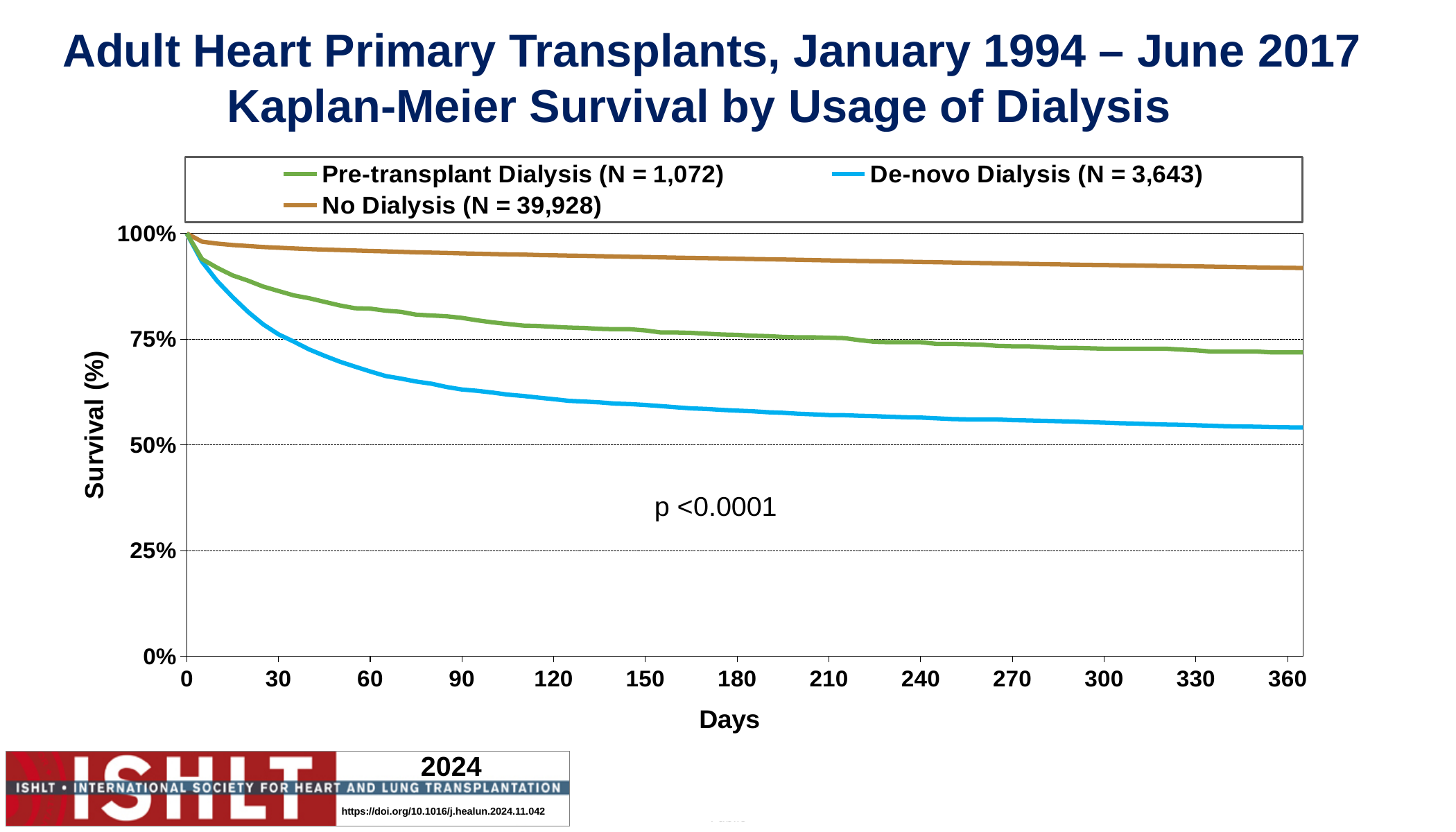
Is the survival for No Dialysis at 360 days greater or less than 75%? greater Is the survival for De-novo Dialysis at 360 days greater or less than 50%? greater What is the N for the No Dialysis group shown in the legend? 39,928 What p-value is printed on the chart? p <0.0001 Which group has the highest survival at 360 days? No Dialysis Is the survival for Pre-transplant Dialysis at 360 days greater or less than 75%? less Which group has the lowest survival at 360 days? De-novo Dialysis Which group has higher survival at 180 days, Pre-transplant Dialysis or De-novo Dialysis? Pre-transplant Dialysis What kind of chart is shown on the slide? line chart Do the survival curves rise or fall as days increase? fall How many series does the legend list? 3